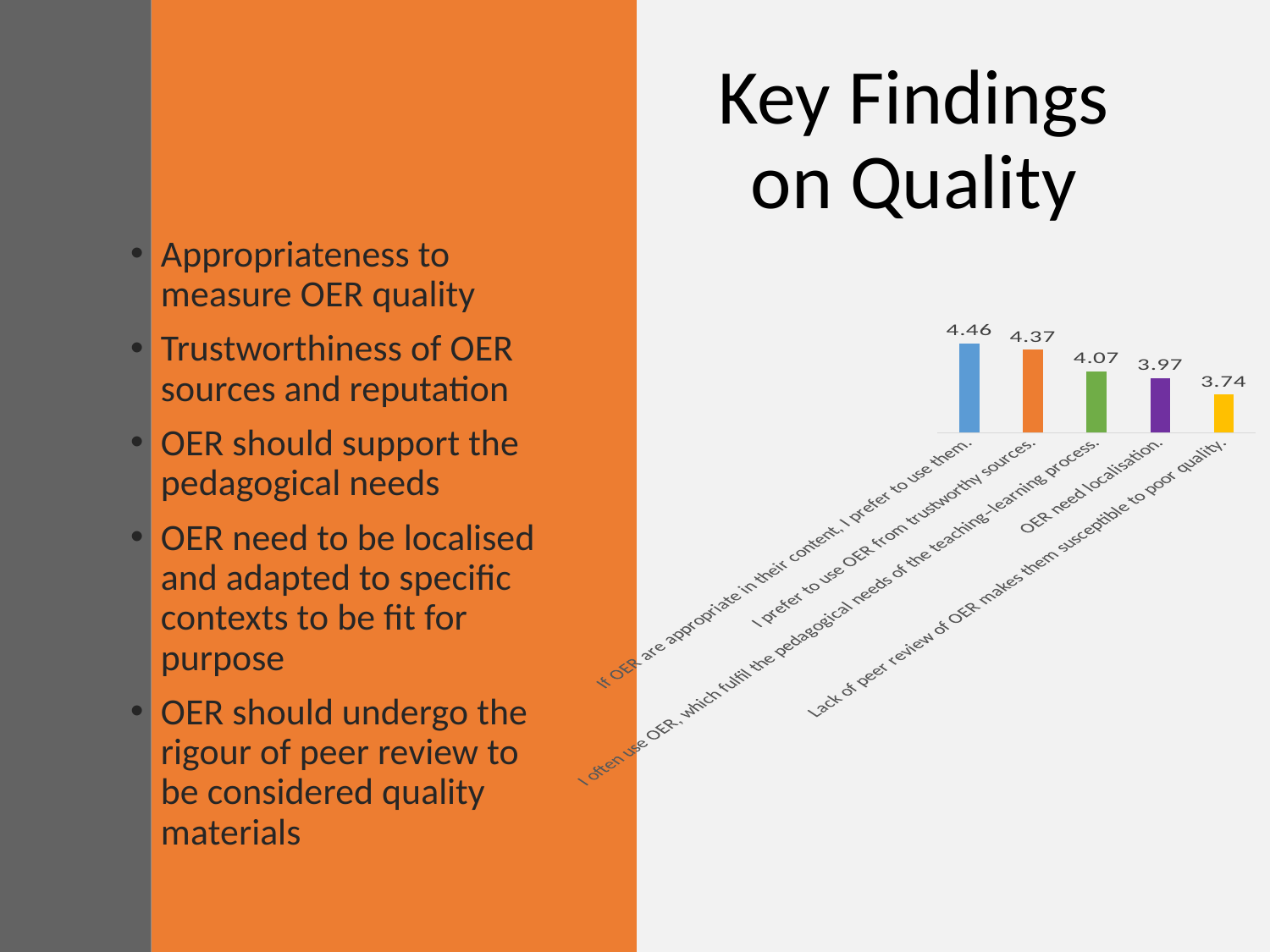
Do the values rise or fall from left to right across the chart? Fall What kind of chart is shown on the slide? Bar chart What is the value for "Lack of peer review of OER makes them susceptible to poor quality."? 3.74 What is the value for "If OER are appropriate in their content, I prefer to use them."? 4.46 Which is larger: the value for "I often use OER, which fulfil the pedagogical needs of the teaching-learning process." or the value for "OER need localisation."? I often use OER, which fulfil the pedagogical needs of the teaching-learning process. What is the difference between the highest and lowest values in the chart? 0.72 Which category has the lowest value? Lack of peer review of OER makes them susceptible to poor quality. Which category has the highest value? If OER are appropriate in their content, I prefer to use them. What is the difference between the values for "I prefer to use OER from trustworthy sources." and "OER need localisation."? 0.40 How many categories are shown in the chart? 5 What is the value for "OER need localisation."? 3.97 What is the value for "I prefer to use OER from trustworthy sources."? 4.37